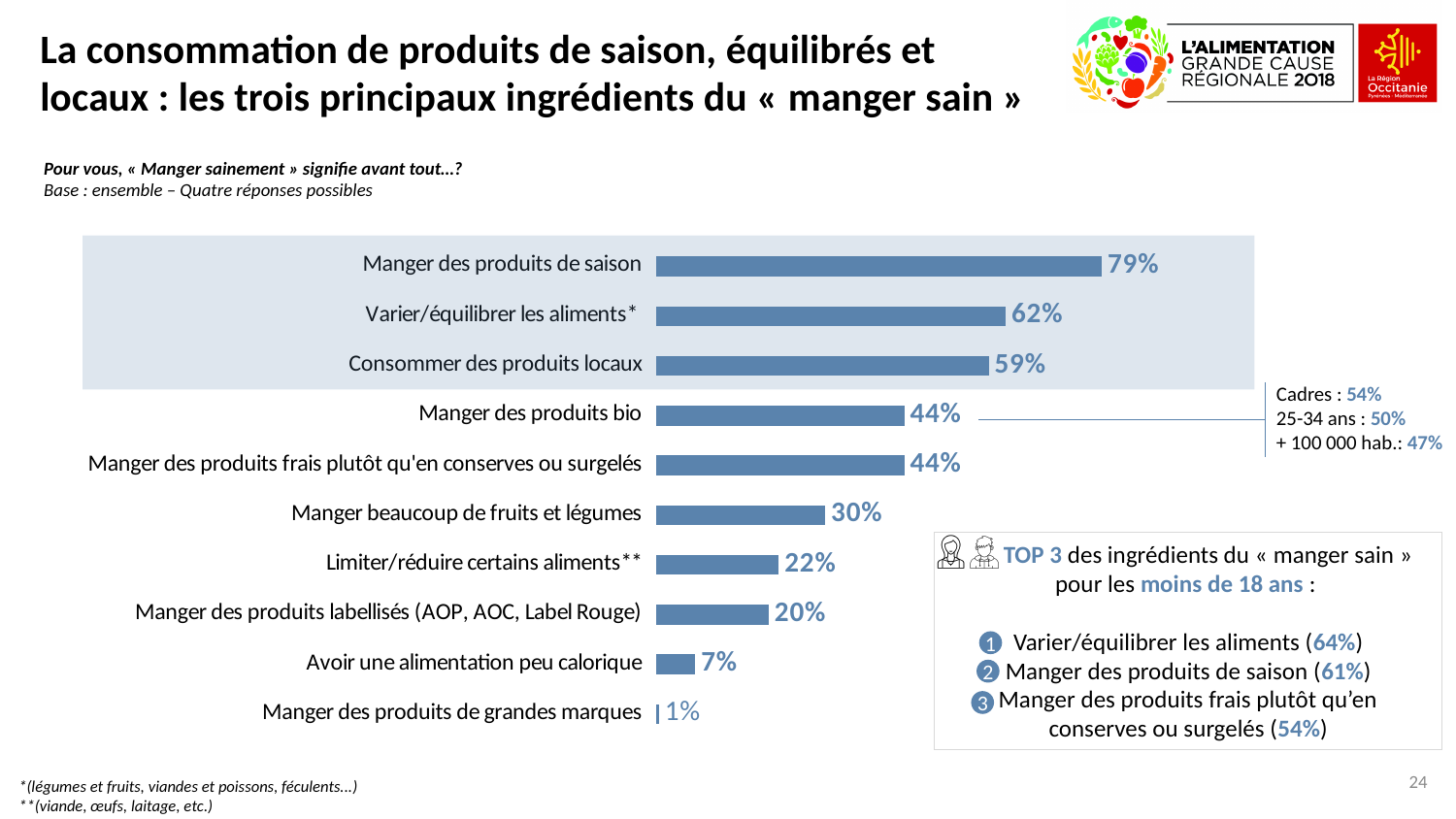
How many categories are shown in the chart? 10 What is the value for "Consommer des produits locaux"? 59% What is the difference between "Limiter/réduire certains aliments" and "Manger des produits labellisés (AOP, AOC, Label Rouge)"? 2% What is the difference between "Manger des produits de saison" and "Varier/équilibrer les aliments"? 17% What value is shown for "Manger des produits bio" and "Manger des produits frais plutôt qu'en conserves ou surgelés"? 44% Which category has the highest value? Manger des produits de saison What is the value for "Manger beaucoup de fruits et légumes"? 30% What is the value for "Avoir une alimentation peu calorique"? 7% What is the value for "Manger des produits de saison"? 79% Which category has the lowest value? Manger des produits de grandes marques What kind of chart is shown on the slide? Bar chart Which is larger: "Consommer des produits locaux" or "Manger des produits bio"? Consommer des produits locaux